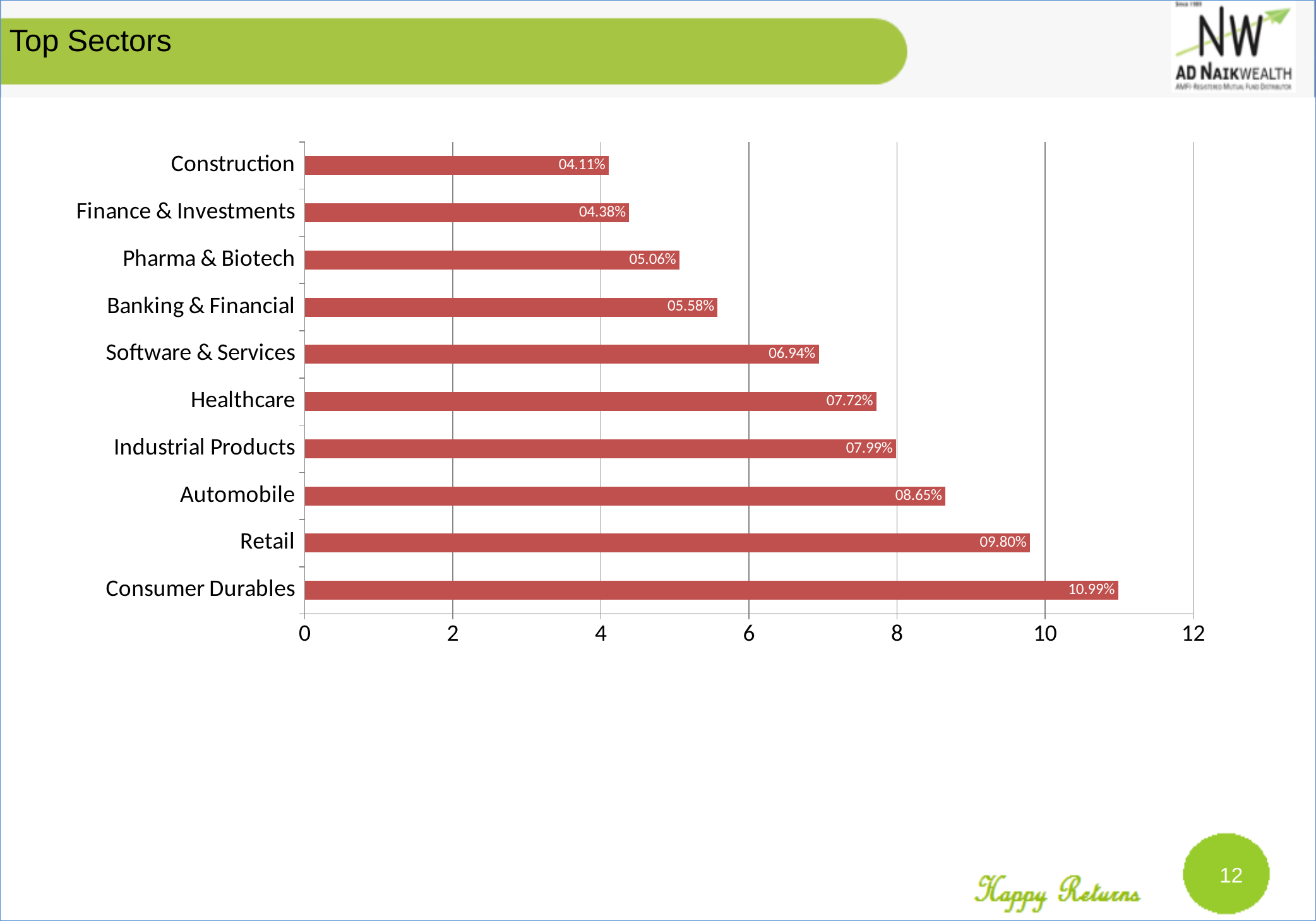
What is the value for Pharma & Biotech? 05.06% What is the value for Construction? 04.11% What is the title of the slide? Top Sectors Which sector has the highest value? Consumer Durables What kind of chart is shown on the slide? Bar chart What is the value for Healthcare? 07.72% What is the difference between the values for Retail and Automobile? 1.15% Which is larger, the value for Software & Services or the value for Banking & Financial? Software & Services Is the value for Industrial Products greater or less than 6? greater How many sectors are shown in the chart? 10 Which sector has the lowest value? Construction What is the value for Consumer Durables? 10.99%